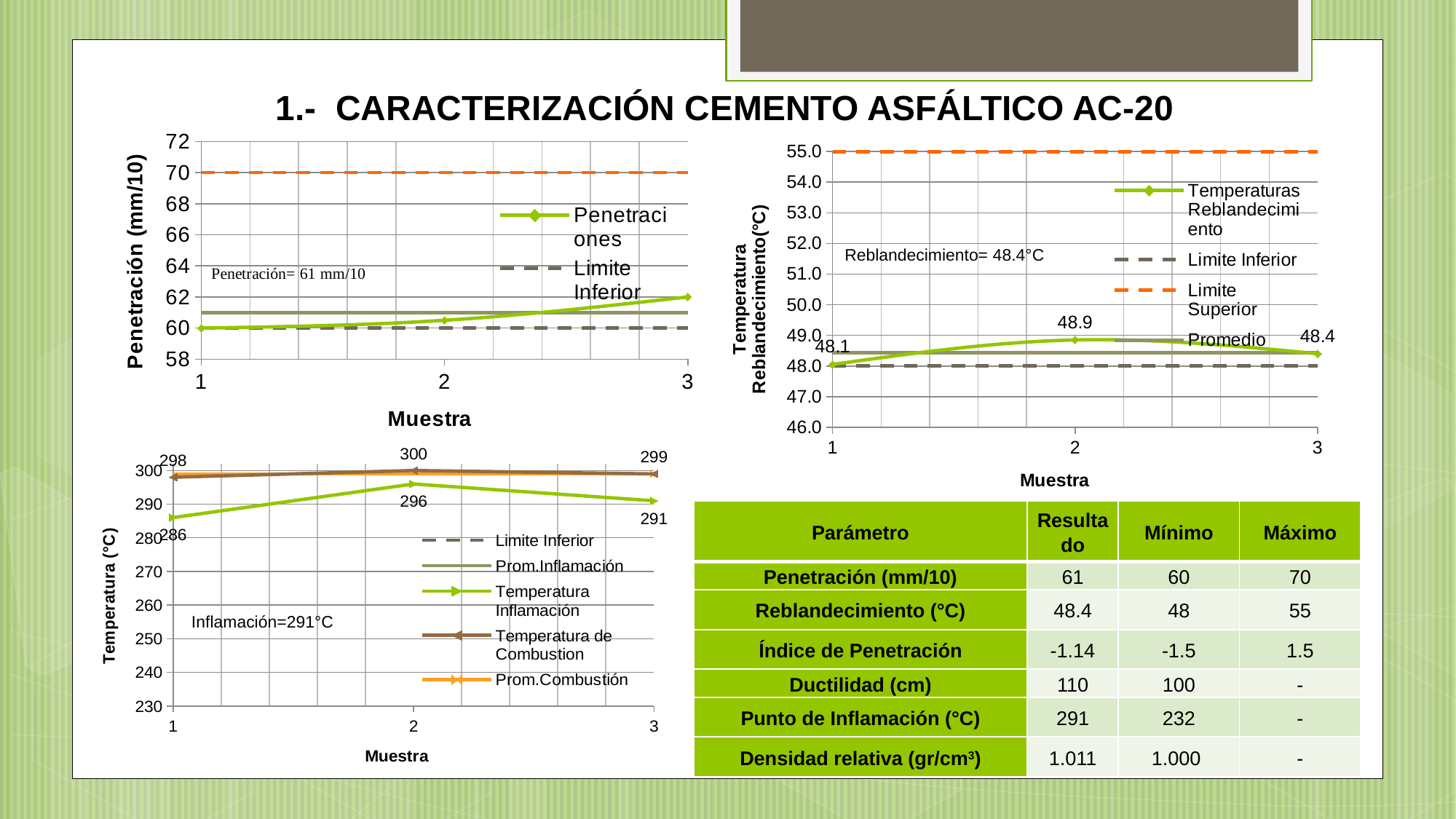
In the Temperatura Reblandecimiento chart (top right), what is the value for sample 2? 48.9 In the bottom-left temperature chart, what is the Temperatura Inflamación value for sample 1? 286 In the bottom-left temperature chart, which is higher at sample 2: Temperatura Inflamación or Temperatura de Combustion? Temperatura de Combustion In the bottom-left temperature chart, how many series does the legend list? 5 In the Temperatura Reblandecimiento chart (top right), at what value does the Limite Superior line sit? 55.0 In the Temperatura Reblandecimiento chart (top right), what is the difference between the values for sample 2 and sample 1? 0.8 In the Temperatura Reblandecimiento chart (top right), which sample has the lowest Temperaturas Reblandecimiento value? 1 What kind of chart is the Penetración chart (top left)? line chart In the Penetración chart (top left), is the Penetraciones value for sample 3 greater or less than 64? less In the Temperatura Reblandecimiento chart (top right), which sample has the highest Temperaturas Reblandecimiento value? 2 In the bottom-left temperature chart, what is the difference between Temperatura de Combustion and Temperatura Inflamación at sample 3? 8 In the bottom-left temperature chart, what is the Temperatura de Combustion value for sample 2? 300